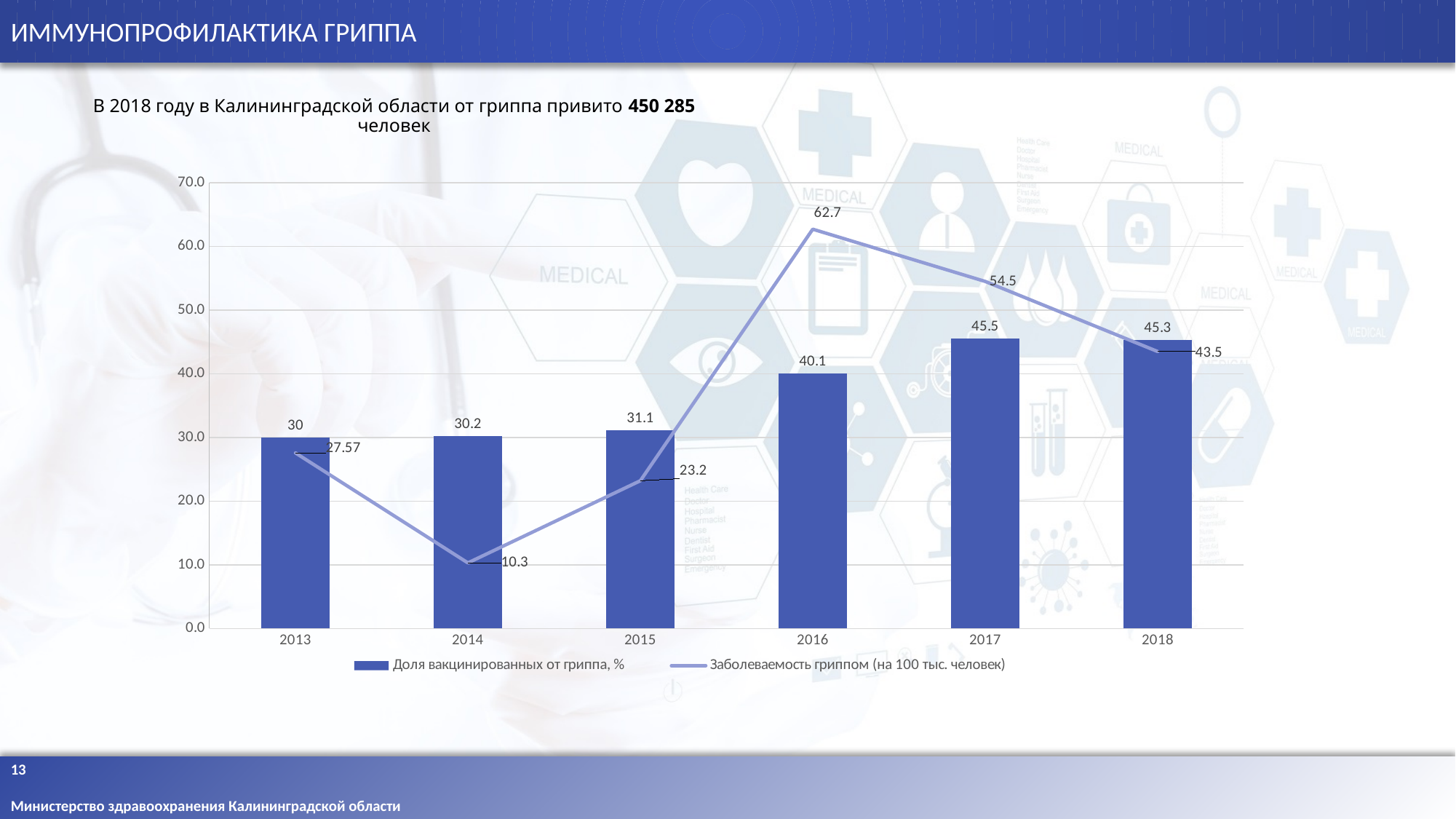
In which year is 'Заболеваемость гриппом (на 100 тыс. человек)' lowest? 2014 What is the difference between 'Доля вакцинированных от гриппа, %' in 2017 and in 2013? 15.5 What is the value of 'Заболеваемость гриппом (на 100 тыс. человек)' for 2014? 10.3 What is the difference between 'Заболеваемость гриппом (на 100 тыс. человек)' in 2016 and in 2014? 52.4 How many years are shown on the x axis of the chart? 6 Which is larger in 2015: 'Доля вакцинированных от гриппа, %' or 'Заболеваемость гриппом (на 100 тыс. человек)'? Доля вакцинированных от гриппа, % What is the value of 'Заболеваемость гриппом (на 100 тыс. человек)' for 2013? 27.57 In which year is 'Заболеваемость гриппом (на 100 тыс. человек)' highest? 2016 How many series does the chart legend list? 2 What is the value of 'Доля вакцинированных от гриппа, %' for 2016? 40.1 Does 'Доля вакцинированных от гриппа, %' rise or fall from 2013 to 2017? rise In which year is 'Доля вакцинированных от гриппа, %' highest? 2017